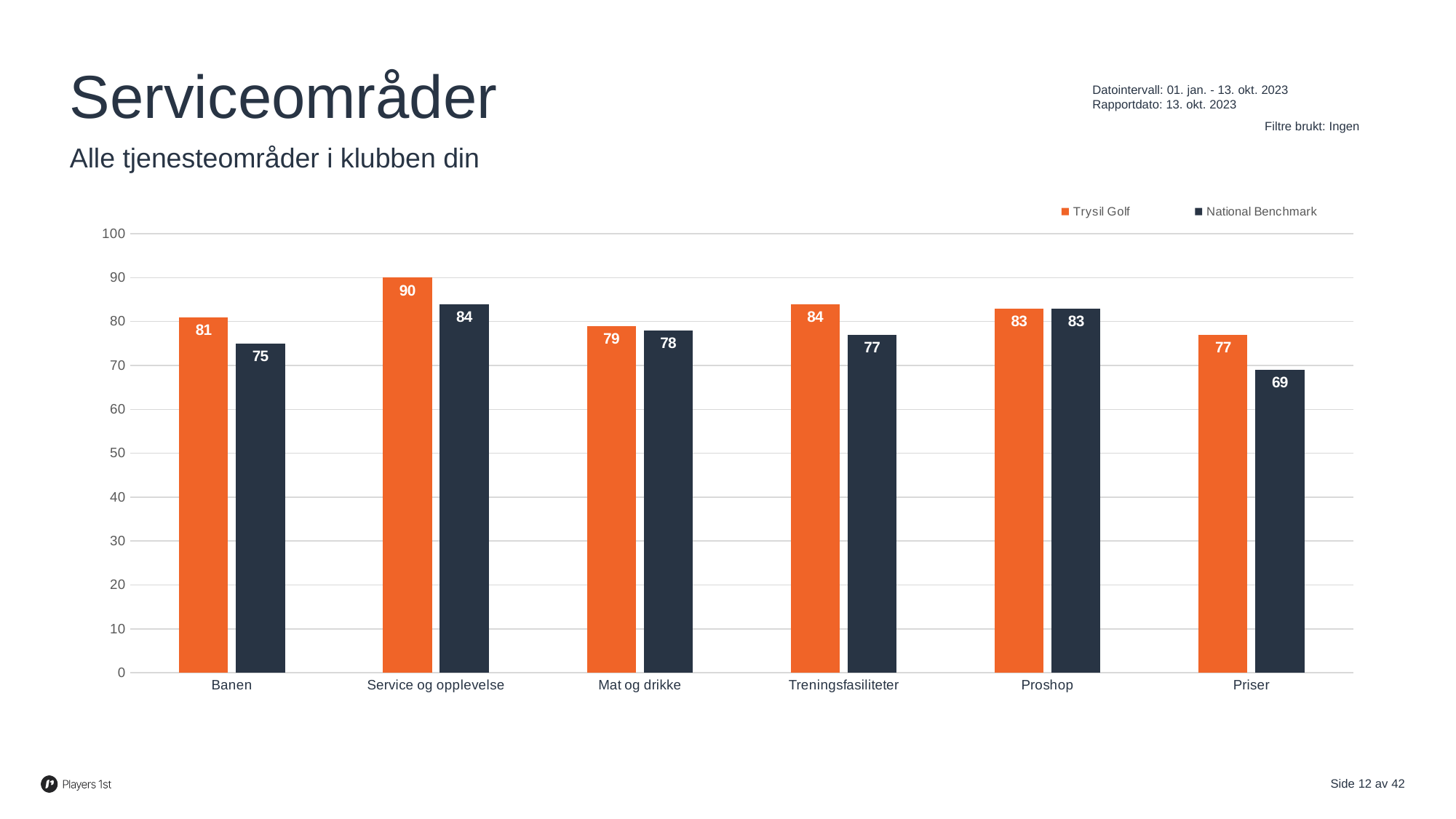
What is the difference between the Trysil Golf and National Benchmark values for Priser? 8 What is the Trysil Golf value for Banen? 81 What is the difference between the Trysil Golf and National Benchmark values for Treningsfasiliteter? 7 Which is larger for Banen, the Trysil Golf value or the National Benchmark value? Trysil Golf Which series is shown in orange? Trysil Golf How many categories are shown on the x axis? 6 Which category has the highest Trysil Golf value? Service og opplevelse What kind of chart is shown on the slide? Bar chart What is the National Benchmark value for Priser? 69 How many series does the legend list? 2 What is the Trysil Golf value for Service og opplevelse? 90 Which category has the lowest National Benchmark value? Priser